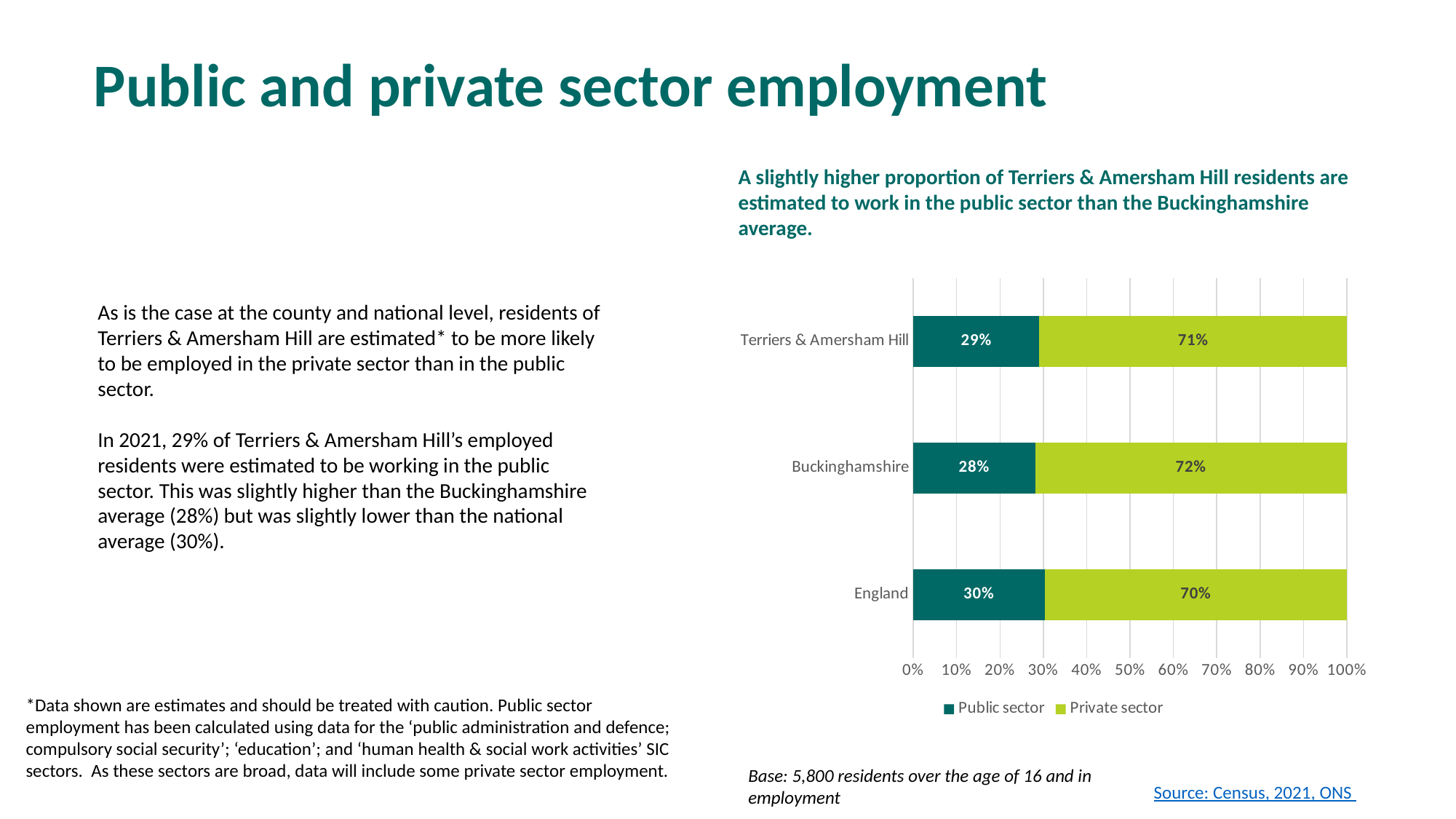
What is the private sector value for Buckinghamshire? 72% What is the public sector value for England? 30% Which area has the highest public sector share? England What is the total of the stacked bar for England? 100% What is the difference between the public sector values for Terriers & Amersham Hill and Buckinghamshire? 1% Is the private sector share larger for Terriers & Amersham Hill or for Buckinghamshire? Buckinghamshire How many series does the legend list? 2 What kind of chart is shown on the slide? Stacked bar chart Which area has the lowest private sector share? England What percentage of Terriers & Amersham Hill residents are estimated to work in the public sector? 29% Which colour represents the public sector in the chart? Dark teal How many areas are shown on the chart? 3